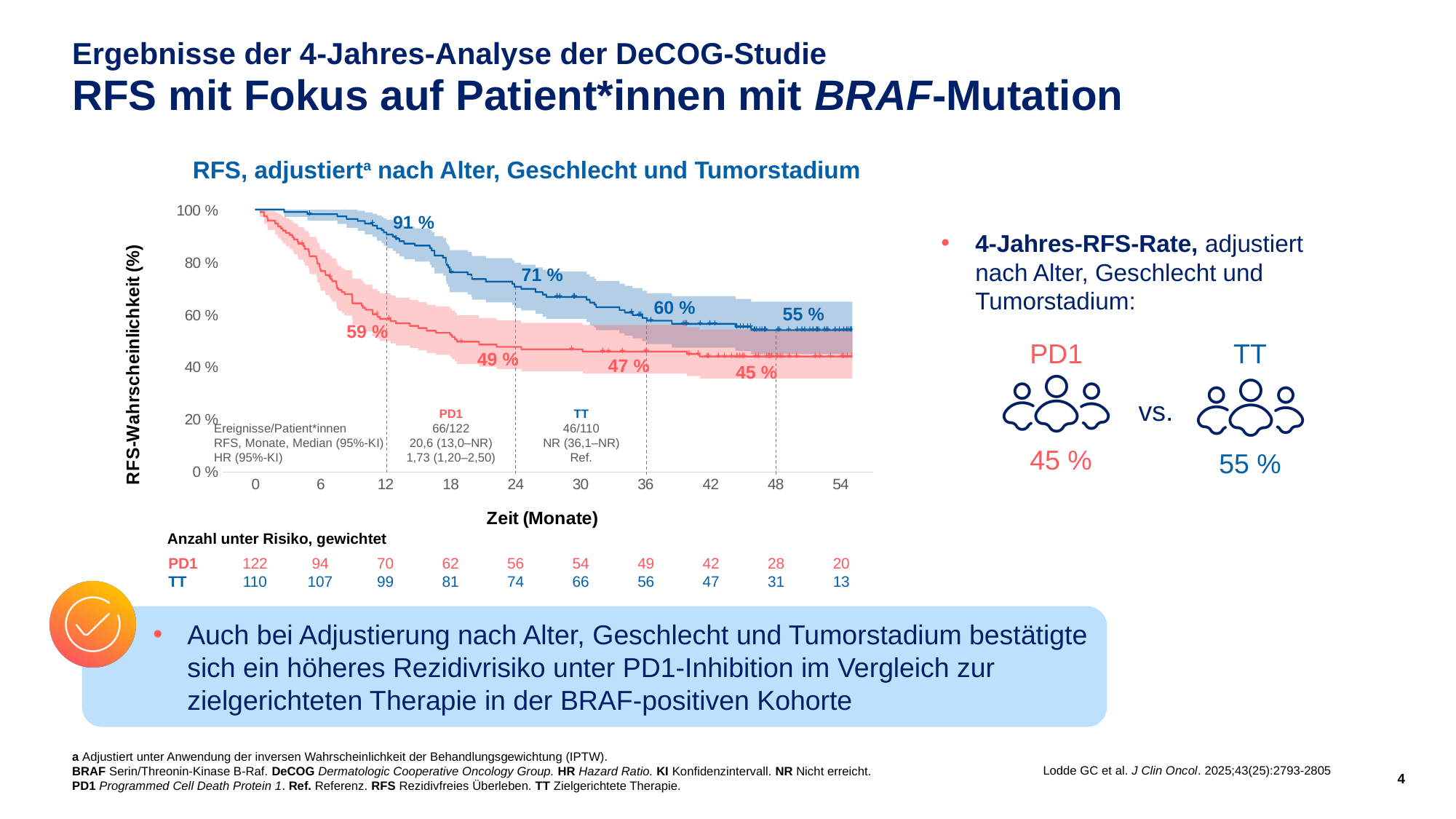
What is the RFS probability for the TT curve at 12 months? 91 % What is the title of the chart? RFS, adjustiert nach Alter, Geschlecht und Tumorstadium Which curve has the higher RFS probability at 36 months, PD1 or TT? TT What is the RFS probability for the PD1 curve at 48 months? 45 % What is the label of the x axis? Zeit (Monate) How many patients in the TT group were at risk at 54 months? 13 How many treatment groups are plotted in the chart? 2 Do the RFS curves rise or fall as time in months increases? fall What is the RFS probability for the TT curve at 48 months? 55 % What is the difference between the TT and PD1 RFS probabilities at 24 months? 22 % What is the RFS probability for the PD1 curve at 12 months? 59 % How many patients in the PD1 group were at risk at 0 months? 122